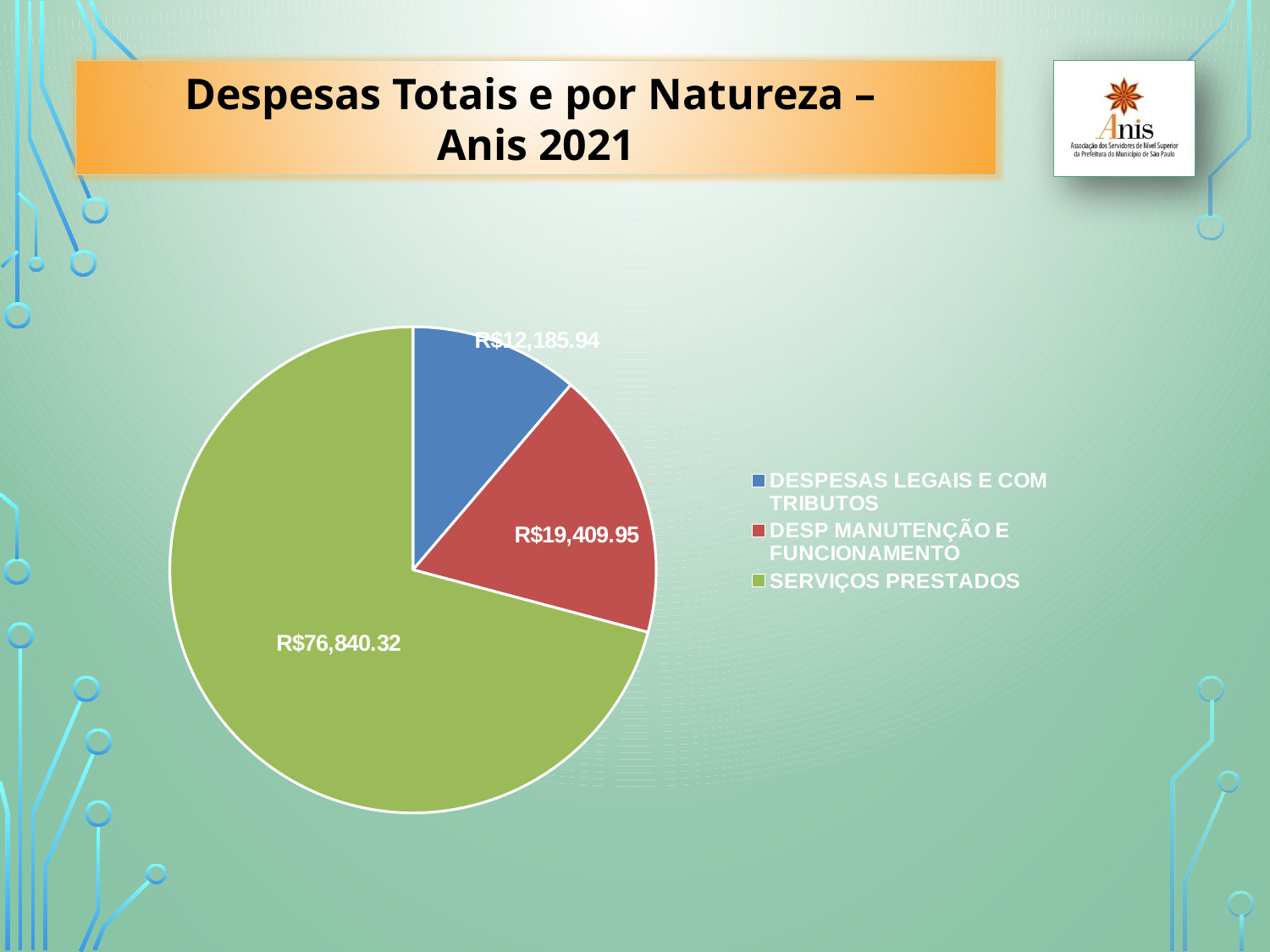
What colour is the slice for SERVIÇOS PRESTADOS? Green How many categories does the pie chart have? 3 Which category has the largest slice of the pie? SERVIÇOS PRESTADOS What is the value for DESPESAS LEGAIS E COM TRIBUTOS? R$12,185.94 What is the difference between SERVIÇOS PRESTADOS and DESP MANUTENÇÃO E FUNCIONAMENTO? R$57,430.37 Which is larger, DESP MANUTENÇÃO E FUNCIONAMENTO or DESPESAS LEGAIS E COM TRIBUTOS? DESP MANUTENÇÃO E FUNCIONAMENTO What is the total of all three slices of the pie? R$108,436.21 What is the value for SERVIÇOS PRESTADOS? R$76,840.32 What is the value for DESP MANUTENÇÃO E FUNCIONAMENTO? R$19,409.95 What is the difference between DESP MANUTENÇÃO E FUNCIONAMENTO and DESPESAS LEGAIS E COM TRIBUTOS? R$7,224.01 Which category has the smallest slice of the pie? DESPESAS LEGAIS E COM TRIBUTOS What type of chart is shown on the slide? Pie chart